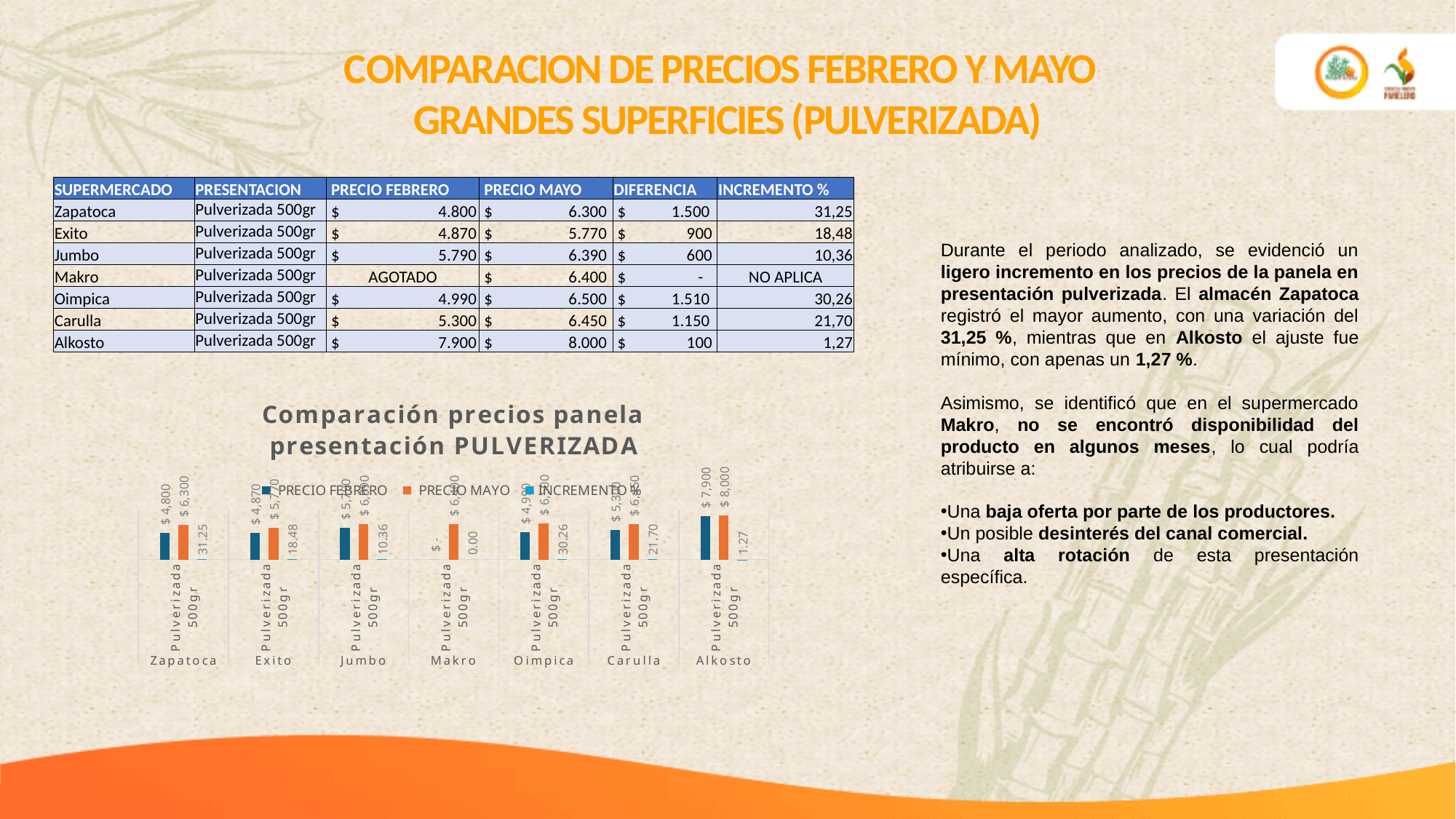
What is the title of the chart on the slide? Comparación precios panela presentación PULVERIZADA In the chart, what is the difference between the PRECIO MAYO and PRECIO FEBRERO values for Alkosto? $ 100 How many series does the chart legend list? 3 In the chart, what is the INCREMENTO % value for Oimpica? 30.26 In the chart, what is the PRECIO MAYO value for Alkosto? $ 8,000 In the chart, which is larger for Zapatoca: the PRECIO FEBRERO bar or the PRECIO MAYO bar? PRECIO MAYO In the chart, what is the PRECIO FEBRERO value for Zapatoca? $ 4,800 Which supermarket has the highest PRECIO MAYO bar in the chart? Alkosto In the chart, what is the INCREMENTO % value for Makro? 0.00 How many supermarkets are shown as categories on the chart's x axis? 7 Which supermarket has the lowest INCREMENTO % value in the chart, excluding Makro's 0.00? Alkosto What type of chart is shown on the slide? Bar chart